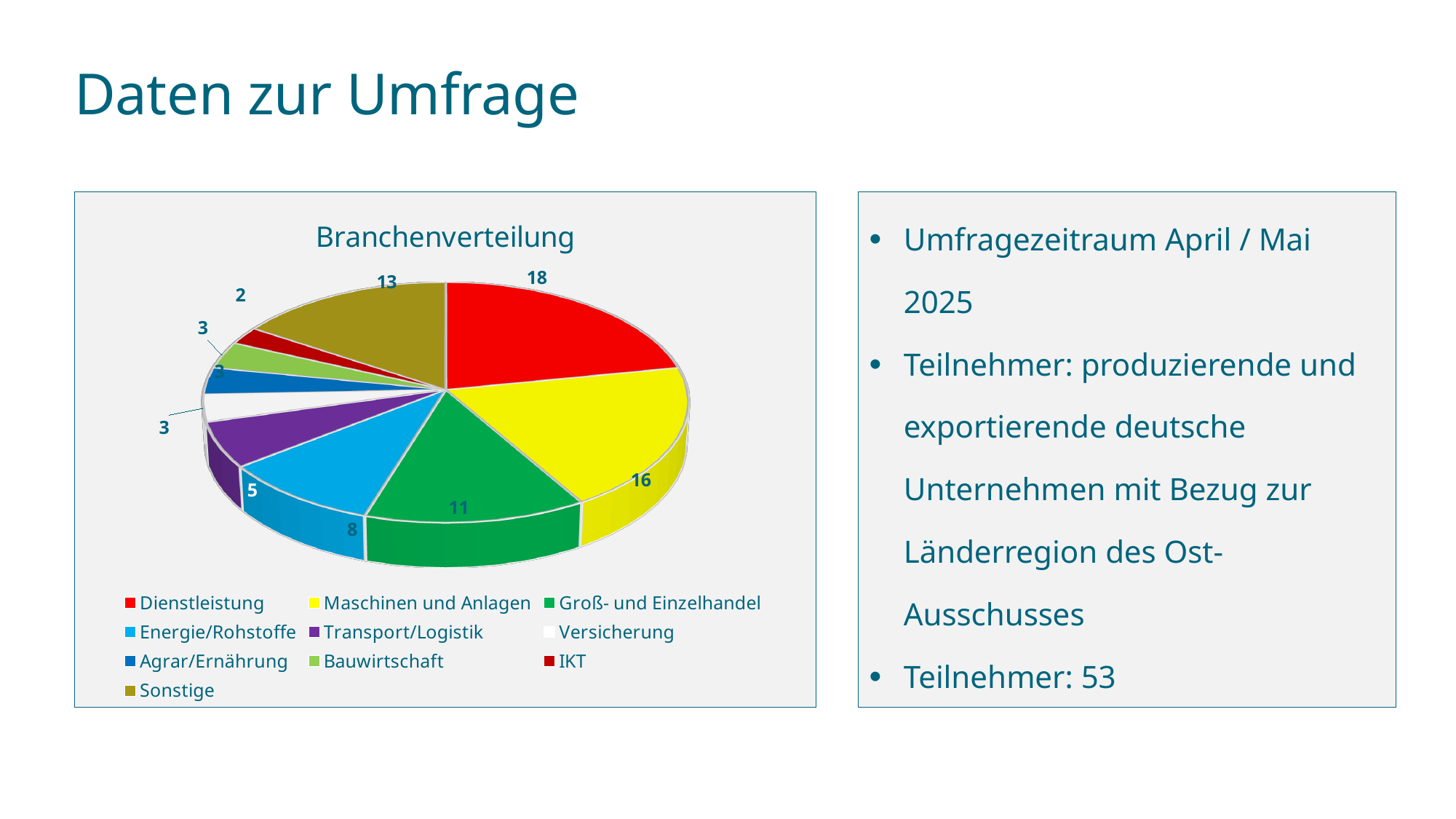
How many categories does the legend of the Branchenverteilung pie chart list? 10 What is the value for IKT in the Branchenverteilung pie chart? 2 What is the value for Sonstige in the Branchenverteilung pie chart? 13 Which category has the smallest slice in the Branchenverteilung pie chart? IKT What is the value for Maschinen und Anlagen in the Branchenverteilung pie chart? 16 Which is larger in the Branchenverteilung pie chart, Transport/Logistik or Energie/Rohstoffe? Energie/Rohstoffe What is the difference between the values for Dienstleistung and Groß- und Einzelhandel in the Branchenverteilung pie chart? 7 What is the value for Dienstleistung in the Branchenverteilung pie chart? 18 What is the value for Energie/Rohstoffe in the Branchenverteilung pie chart? 8 What is the title of the pie chart on the slide? Branchenverteilung Which category has the largest slice in the Branchenverteilung pie chart? Dienstleistung What type of chart is shown under the title "Branchenverteilung"? pie chart